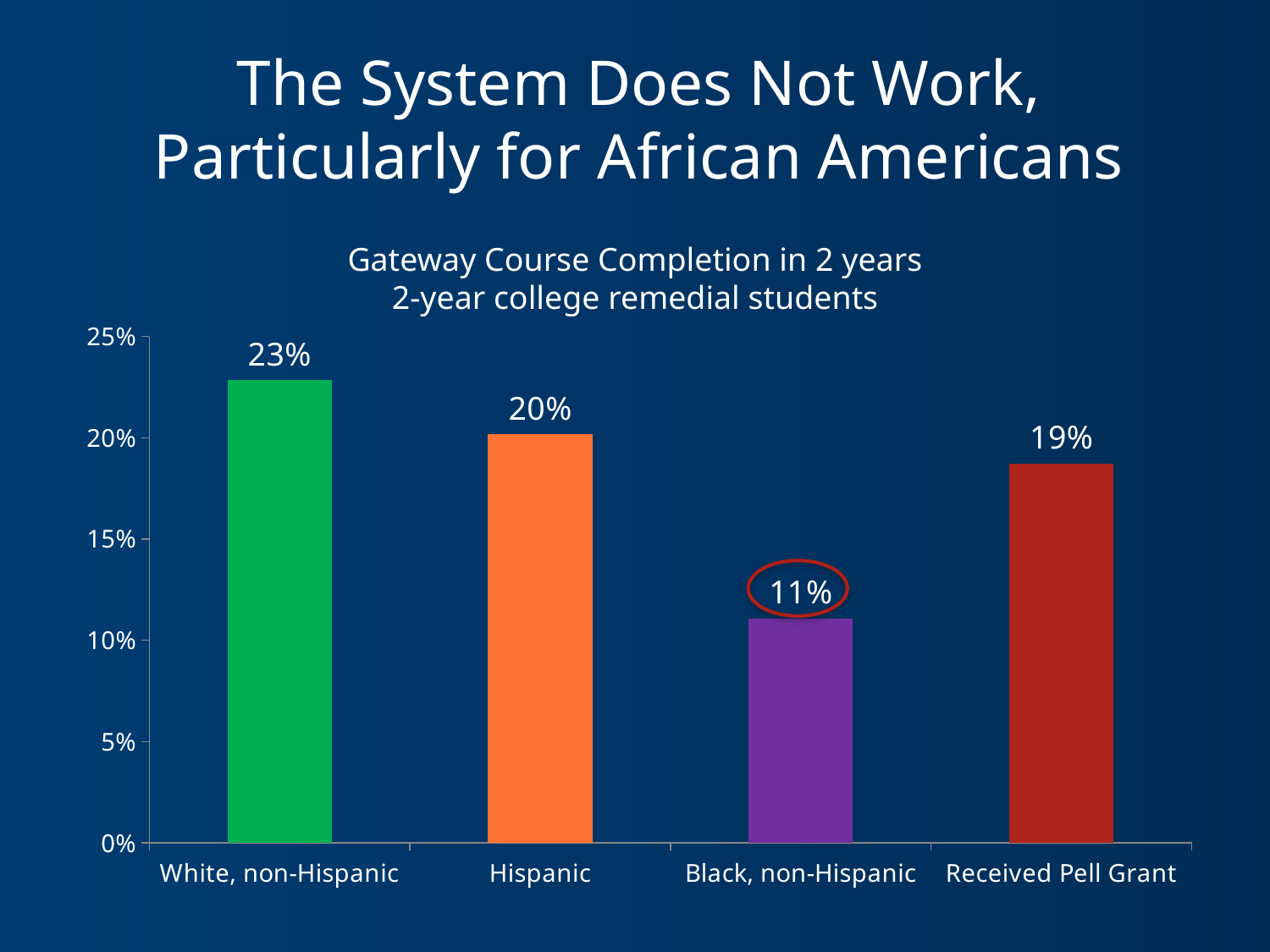
Which category has the lowest gateway course completion rate? Black, non-Hispanic What is the difference in completion rate between White, non-Hispanic and Black, non-Hispanic students? 12% Which has a higher completion rate: Hispanic students or students who received a Pell Grant? Hispanic What is the gateway course completion rate for students who received a Pell Grant? 19% Is the value for Black, non-Hispanic greater or less than 15%? less What is the title of the chart? Gateway Course Completion in 2 years 2-year college remedial students What is the gateway course completion rate for White, non-Hispanic students? 23% What is the gateway course completion rate for Hispanic students? 20% What kind of chart is shown on the slide? Bar chart Which category has the highest gateway course completion rate? White, non-Hispanic How many categories are shown on the chart? 4 What is the gateway course completion rate for Black, non-Hispanic students? 11%